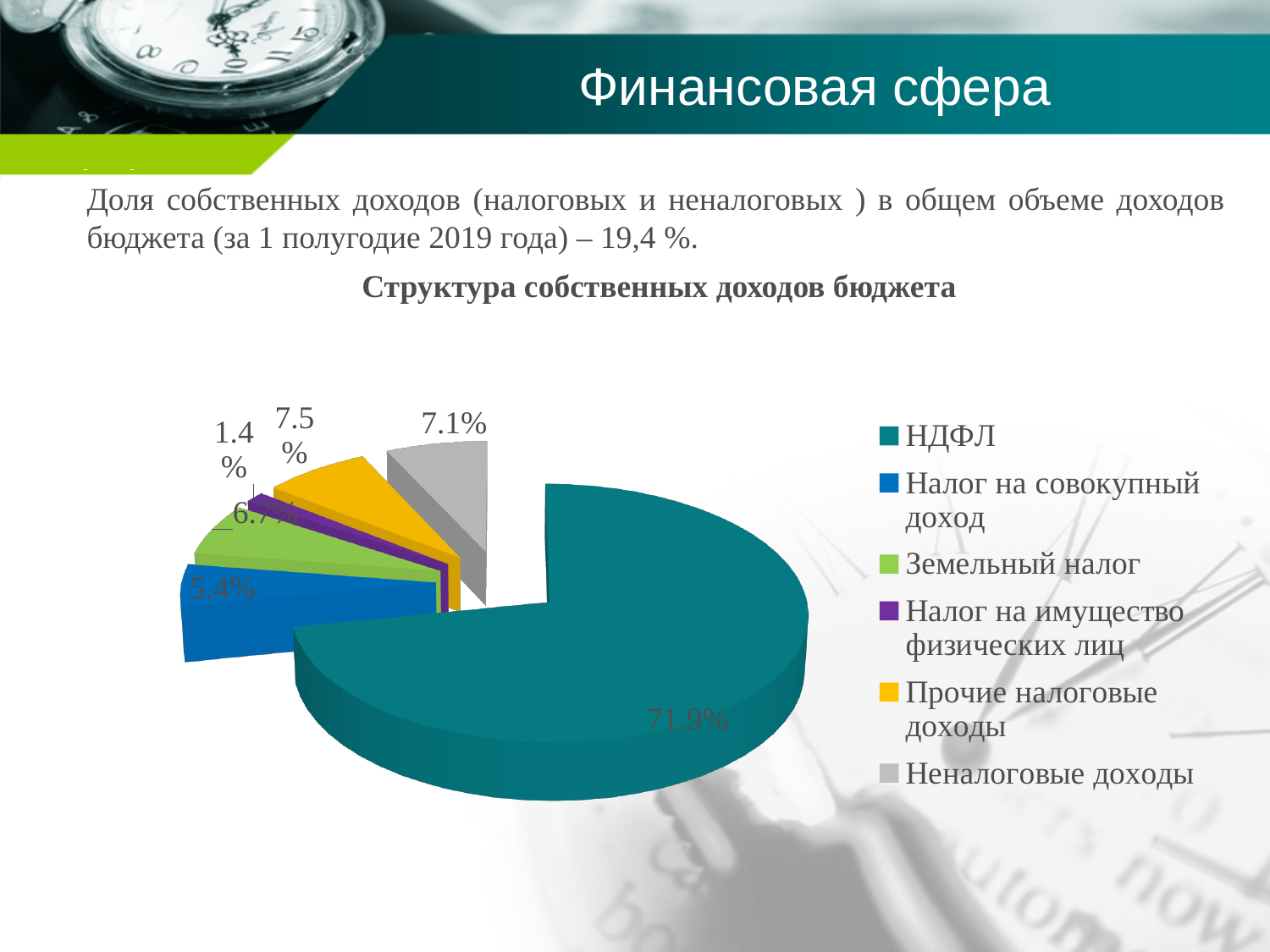
Which category has the largest share of the pie? НДФЛ How many entries does the legend list? 6 What share of the pie is НДФЛ? 71.9% How many slices does the pie chart have? 6 What is the value for Налог на совокупный доход? 5.4% What is the difference between the shares of Прочие налоговые доходы and Неналоговые доходы? 0.4% Which category has the smallest share of the pie? Налог на имущество физических лиц What is the value for Земельный налог? 6.7% What is the value for Неналоговые доходы? 7.1% What type of chart is shown on the slide? pie chart What is the title of the chart? Структура собственных доходов бюджета Which is larger, the share of Земельный налог or the share of Налог на совокупный доход? Земельный налог